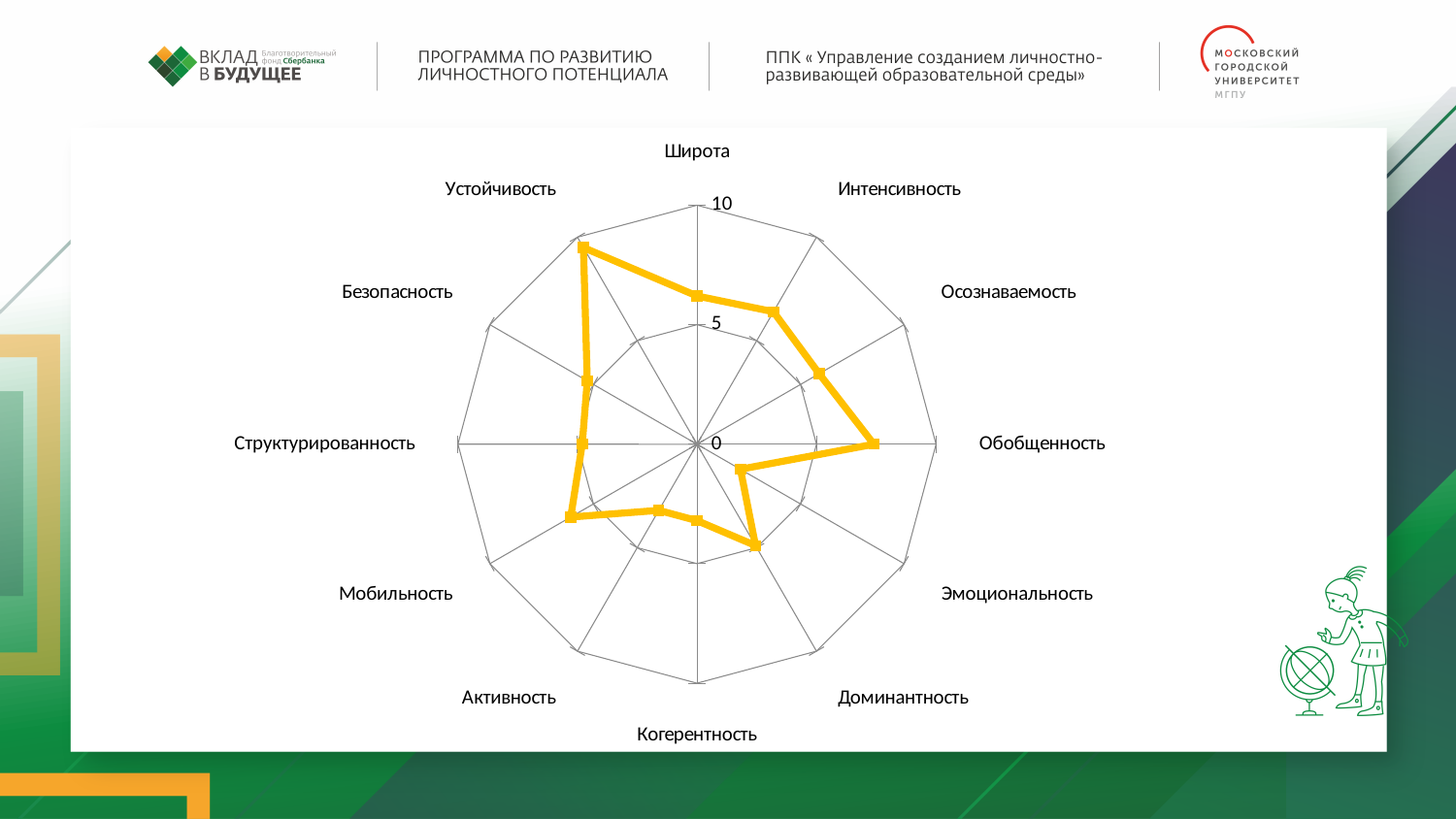
What is the maximum value shown on the radar chart's axis scale? 10 How many categories (axes) does the radar chart have? 12 What kind of chart is shown on the slide? radar chart Which is larger, the value for Устойчивость or the value for Эмоциональность? Устойчивость Which category has the lowest value on the radar chart? Эмоциональность Is the value for Когерентность greater or less than 5? less Is the value for Устойчивость greater or less than 5? greater Is the value for Обобщенность greater or less than 5? greater Which is larger, the value for Обобщенность or the value for Когерентность? Обобщенность Which category has the highest value on the radar chart? Устойчивость